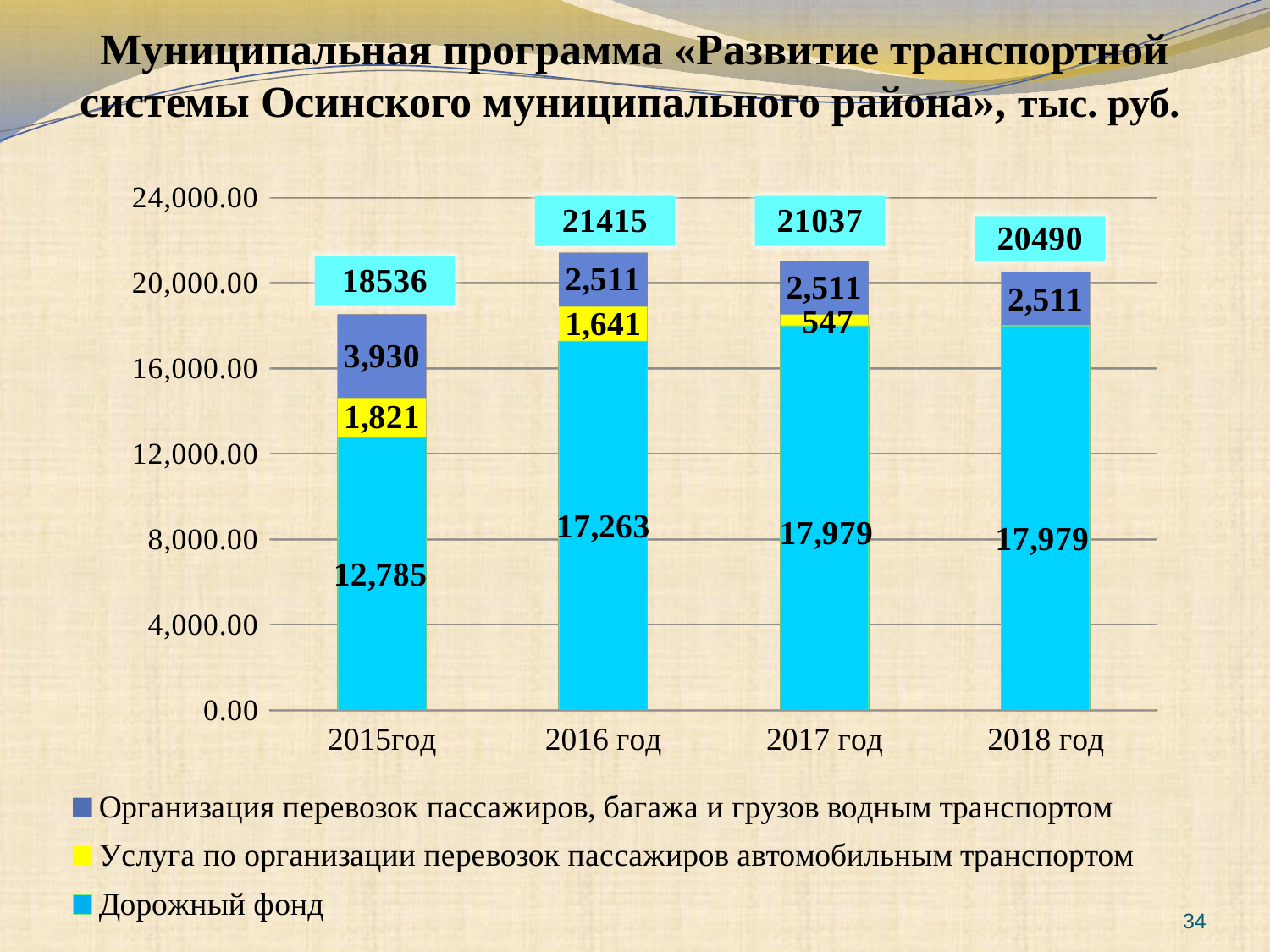
How many series does the legend list? 3 What type of chart is shown on the slide? Stacked bar chart Which year has the lowest total? 2015год What is the value of Организация перевозок пассажиров, багажа и грузов водным транспортом for 2015год? 3,930 What is the total labelled above the bar for 2016 год? 21415 What is the value of Услуга по организации перевозок пассажиров автомобильным транспортом for 2017 год? 547 Which year has the highest total? 2016 год What is the value of Дорожный фонд for 2015год? 12,785 Which is larger: the Услуга по организации перевозок пассажиров автомобильным транспортом value for 2015год or for 2016 год? 2015год Which series is shown in yellow in the legend? Услуга по организации перевозок пассажиров автомобильным транспортом What is the difference between the Дорожный фонд values for 2016 год and 2015год? 4,478 How many year categories are shown on the x axis? 4